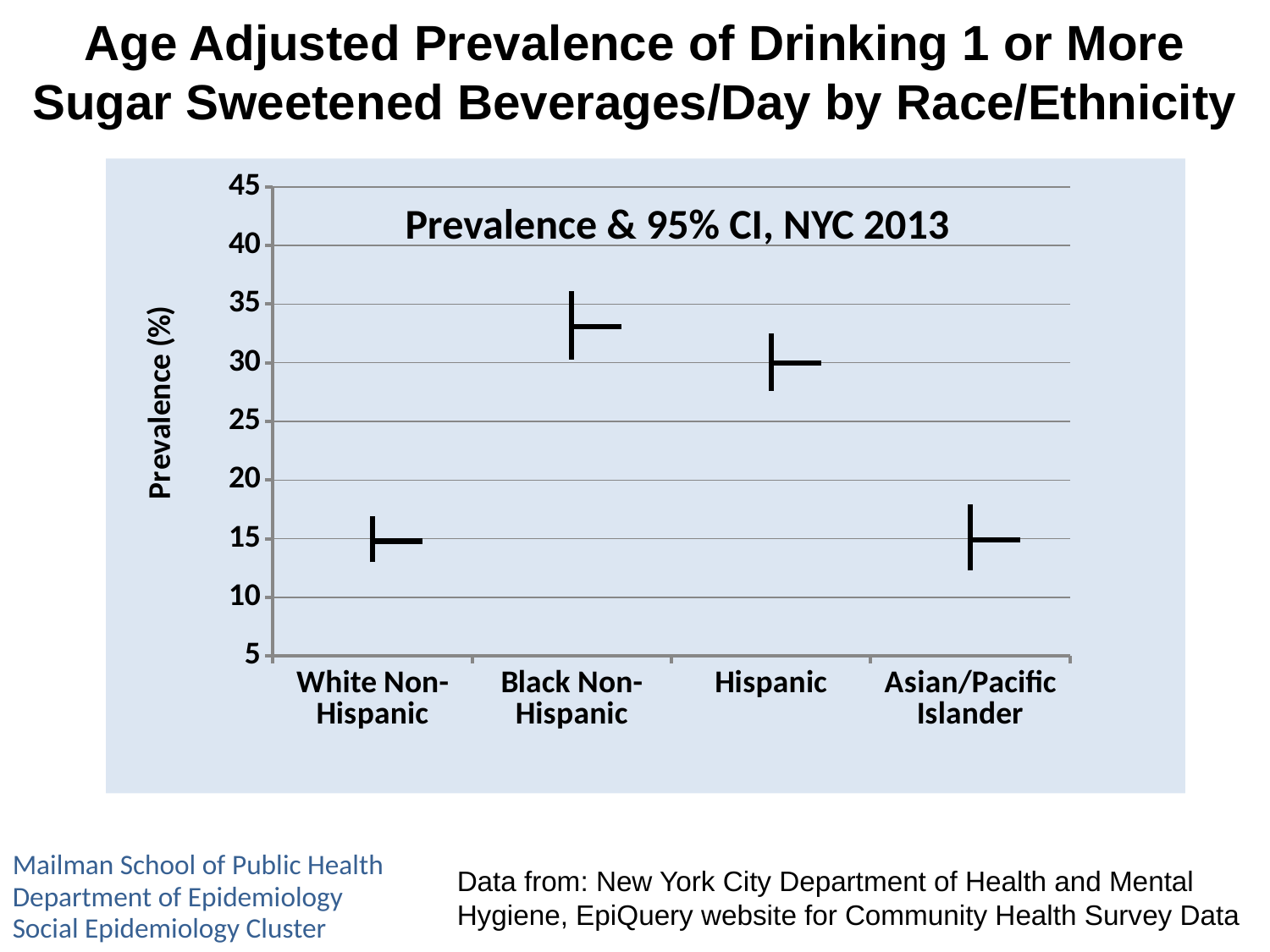
What is the label of the y axis? Prevalence (%) Which has a higher prevalence, Hispanic or Asian/Pacific Islander? Hispanic What is the title printed inside the chart area? Prevalence & 95% CI, NYC 2013 Which has a higher prevalence, White Non-Hispanic or Black Non-Hispanic? Black Non-Hispanic Is the prevalence for Asian/Pacific Islander greater or less than 20? less Is the prevalence for Black Non-Hispanic greater or less than 30? greater Is the prevalence for Hispanic greater or less than 25? greater Which has a higher prevalence, Black Non-Hispanic or Hispanic? Black Non-Hispanic How many race/ethnicity categories are shown on the x axis? 4 Which race/ethnicity group has the highest prevalence in the chart? Black Non-Hispanic